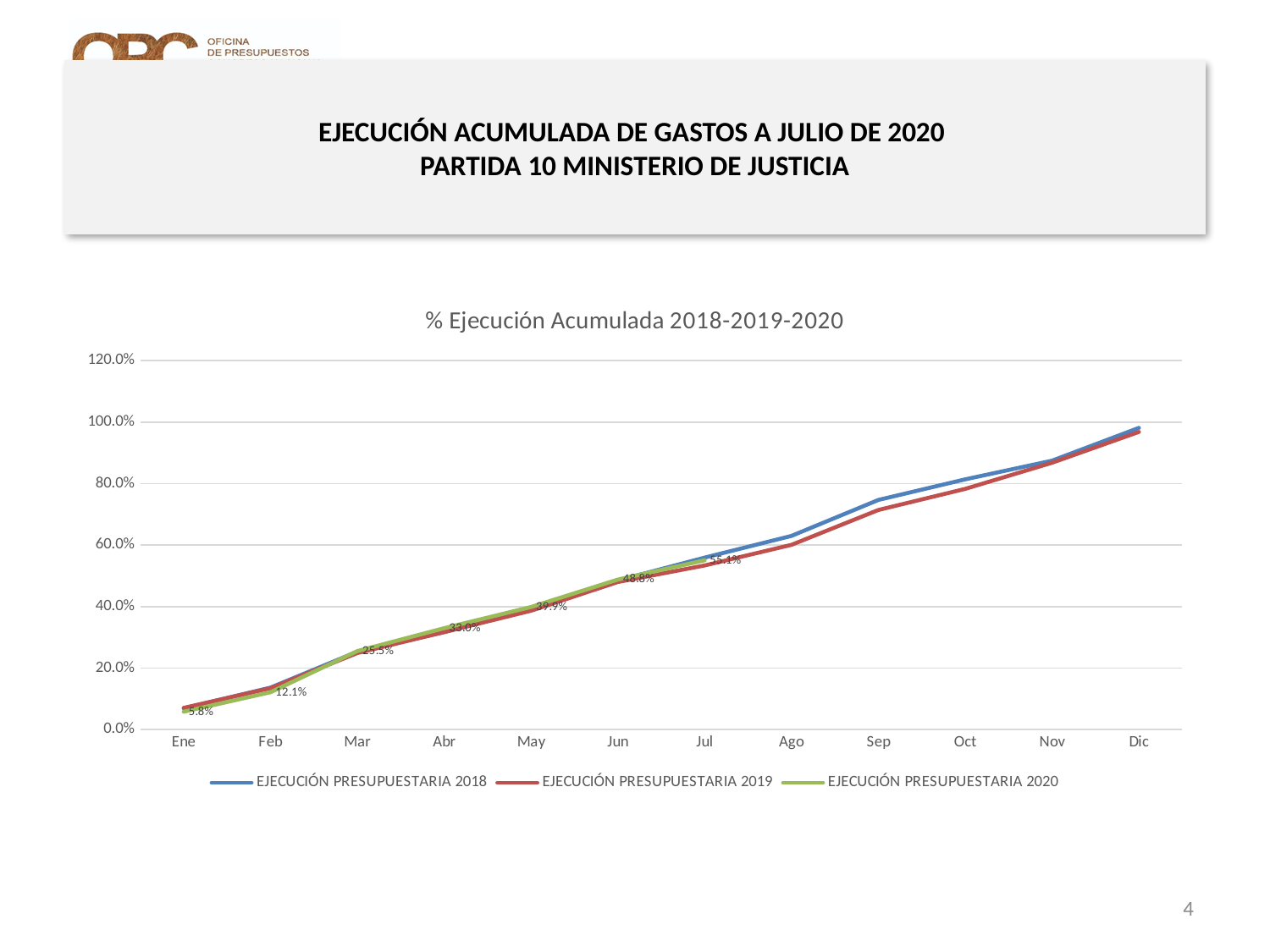
What is the title of the chart? % Ejecución Acumulada 2018-2019-2020 What is the value for EJECUCIÓN PRESUPUESTARIA 2020 in Jul? 55.1% What is the value for EJECUCIÓN PRESUPUESTARIA 2020 in Feb? 12.1% What is the value for EJECUCIÓN PRESUPUESTARIA 2020 in Ene? 5.8% Do the values for EJECUCIÓN PRESUPUESTARIA 2020 rise or fall from Ene to Jul? rise What is the difference between the EJECUCIÓN PRESUPUESTARIA 2020 values for Jul and Ene? 49.3% Is the value for EJECUCIÓN PRESUPUESTARIA 2018 in Dic greater or less than 80.0%? greater How many months are shown on the x axis? 12 What is the value for EJECUCIÓN PRESUPUESTARIA 2020 in Abr? 33.0% In Sep, which series has the larger value, EJECUCIÓN PRESUPUESTARIA 2018 or EJECUCIÓN PRESUPUESTARIA 2019? EJECUCIÓN PRESUPUESTARIA 2018 How many series does the legend list? 3 What kind of chart is shown on the slide? line chart